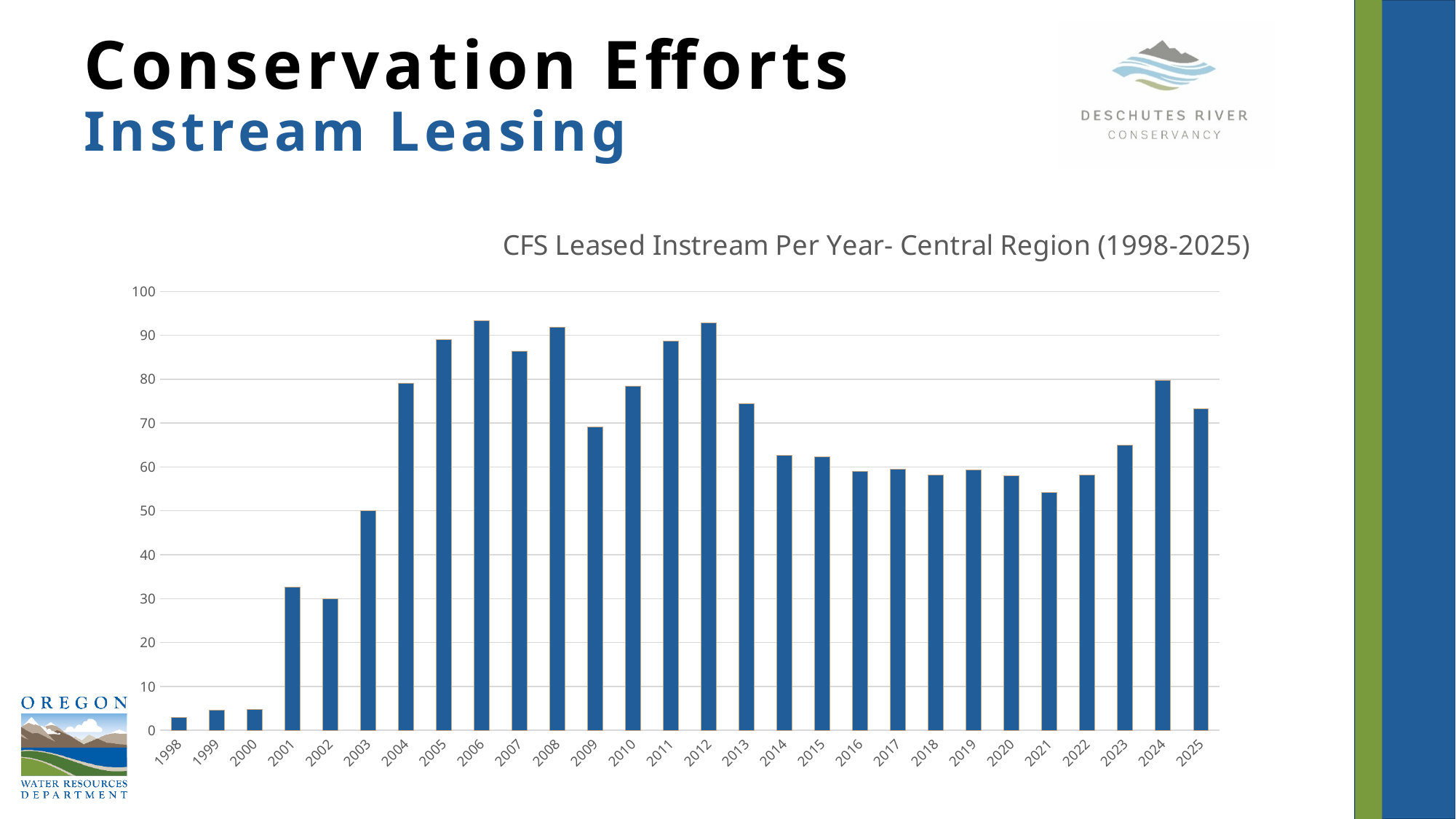
Which year has the larger value, 2008 or 2009? 2008 Is the value for 2023 greater or less than 60? greater Which year has the lowest value on the chart? 1998 Is the value for 2007 greater or less than 80? greater What is the title of the chart? CFS Leased Instream Per Year- Central Region (1998-2025) What kind of chart is shown on the slide? bar chart Which year has the larger value, 2024 or 2025? 2024 Is the value for 2021 greater or less than 60? less Do the values generally rise or fall from 1998 to 2006? rise How many years (bars) are plotted on the chart? 28